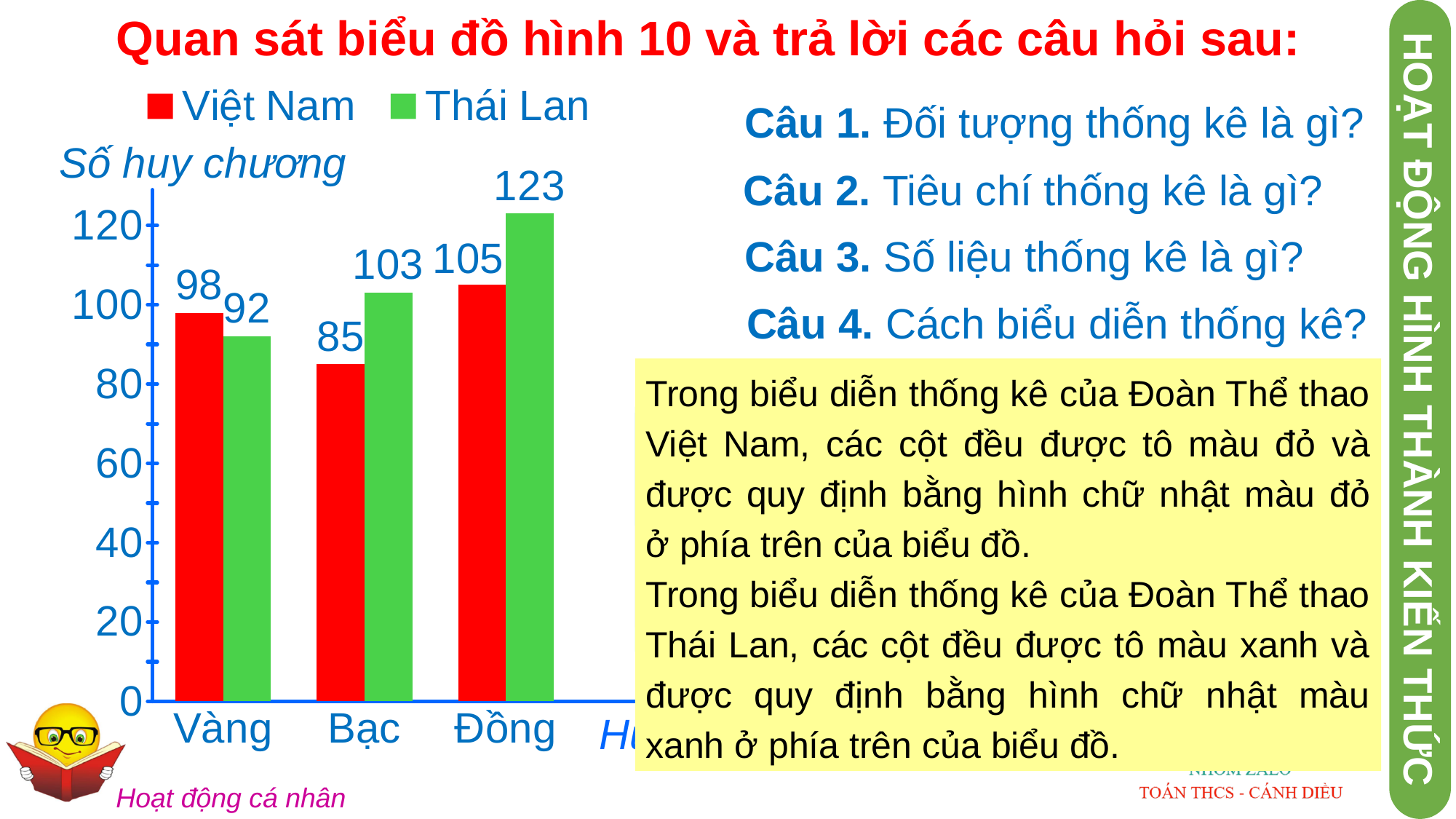
In which category does Việt Nam have its lowest value? Bạc What is the value for Thái Lan in the Bạc category? 103 What is the difference between Thái Lan and Việt Nam in the Đồng category? 18 In which category does Thái Lan have its highest value? Đồng What is the number of medals for Việt Nam in the Vàng category? 98 How many series does the legend list? 2 What kind of chart is shown on the slide? Bar chart What is the label of the vertical axis? Số huy chương What is the number of medals for Thái Lan in the Đồng category? 123 Which is larger in the Bạc category, Việt Nam or Thái Lan? Thái Lan How many categories are shown on the x axis? 3 What is the difference between Việt Nam and Thái Lan in the Vàng category? 6